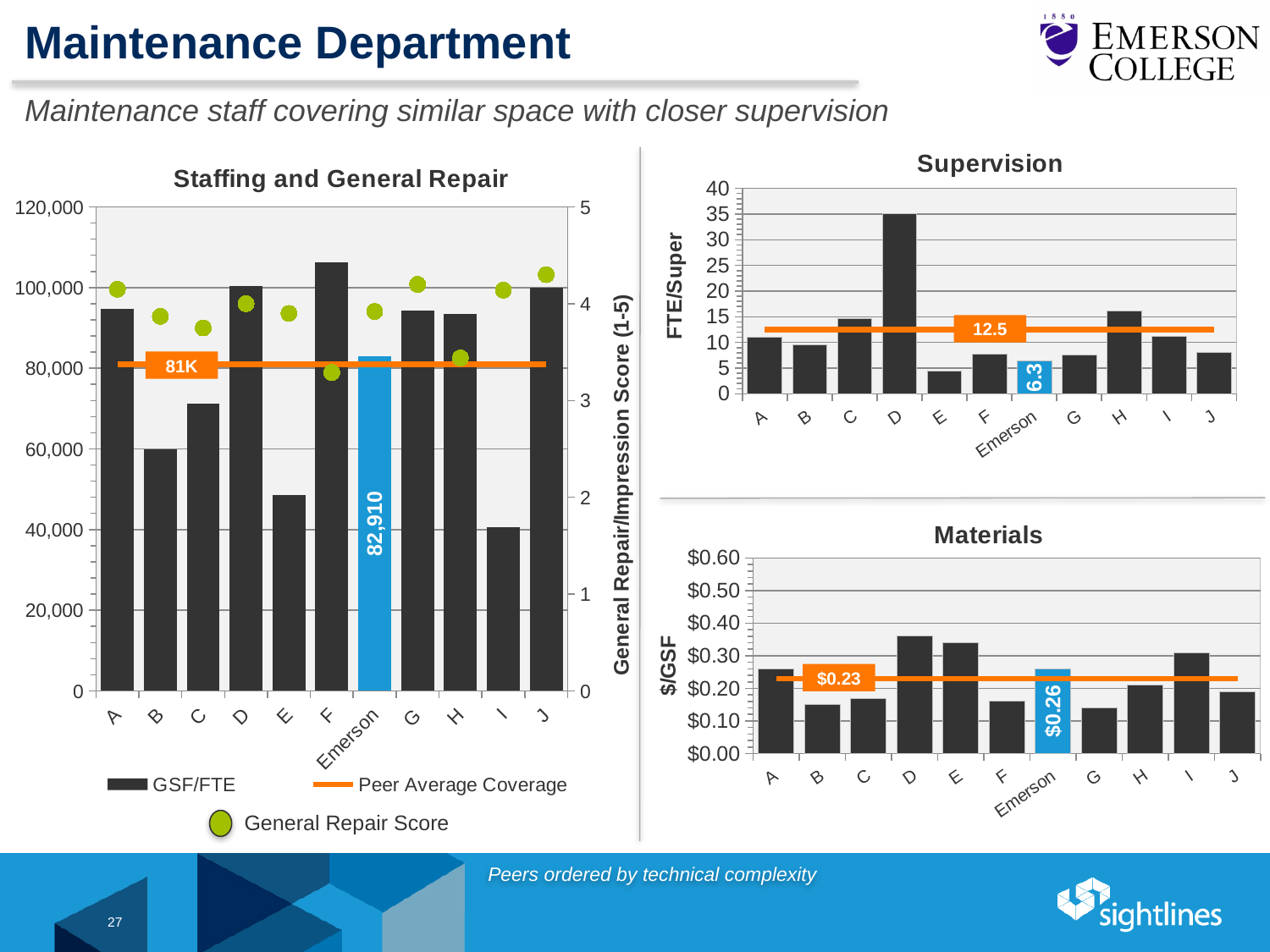
In the Supervision chart, what is the difference between the peer average (12.5) and Emerson's value (6.3)? 6.2 In the Staffing and General Repair chart, which peer has the highest GSF/FTE bar? F In the Staffing and General Repair chart, which peer has the lowest GSF/FTE bar? I In the Staffing and General Repair chart, what is the GSF/FTE value labeled on the Emerson bar? 82,910 In the Supervision chart, which peer has the highest FTE/Super bar? D In the Materials chart, what is the $/GSF value labeled on the Emerson bar? $0.26 How many entries does the legend of the Staffing and General Repair chart list? 3 In the Supervision chart, is the value for D greater or less than 30? greater In the Supervision chart, what is the FTE/Super value labeled on the Emerson bar? 6.3 In the Staffing and General Repair chart, is the GSF/FTE value for E greater or less than 60,000? less In the Materials chart, which is larger: Emerson's value or the peer average line? Emerson's value In the Staffing and General Repair chart, what is the Peer Average Coverage value shown on the orange line? 81K